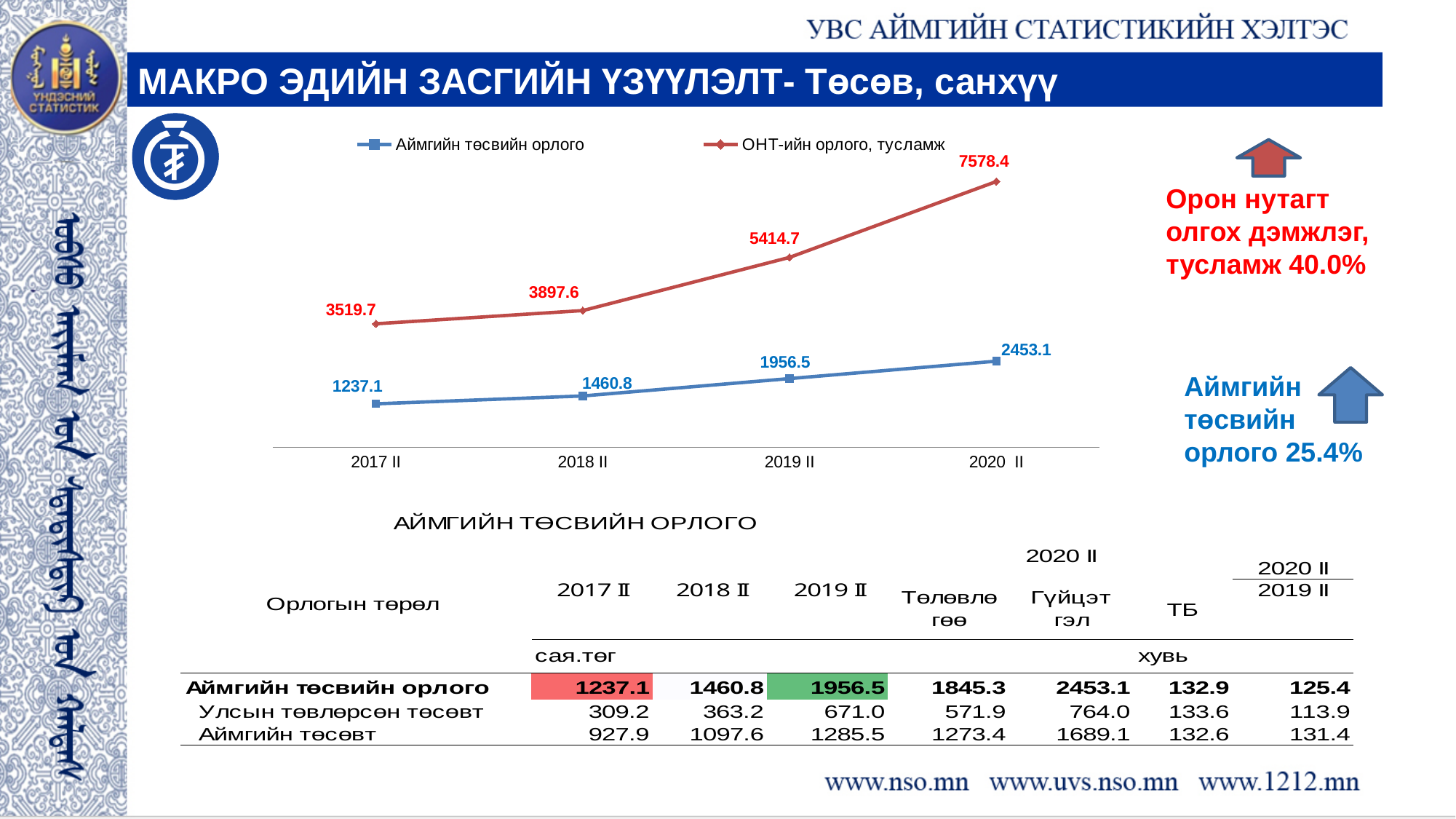
What is the difference between ОНТ-ийн орлого, тусламж in 2020 II and 2019 II? 2163.7 Does Аймгийн төсвийн орлого rise or fall from 2017 II to 2020 II? rise In which period is ОНТ-ийн орлого, тусламж lowest? 2017 II How many series does the chart legend list? 2 What type of chart is shown on the slide? line chart What is the value of ОНТ-ийн орлого, тусламж for 2020 II? 7578.4 Which colour is used for the ОНТ-ийн орлого, тусламж line? red In which period is Аймгийн төсвийн орлого highest? 2020 II What is the value of Аймгийн төсвийн орлого for 2017 II? 1237.1 How many time points are plotted along the x axis of the chart? 4 What is the value of ОНТ-ийн орлого, тусламж for 2018 II? 3897.6 Which is larger in 2019 II: Аймгийн төсвийн орлого or ОНТ-ийн орлого, тусламж? ОНТ-ийн орлого, тусламж